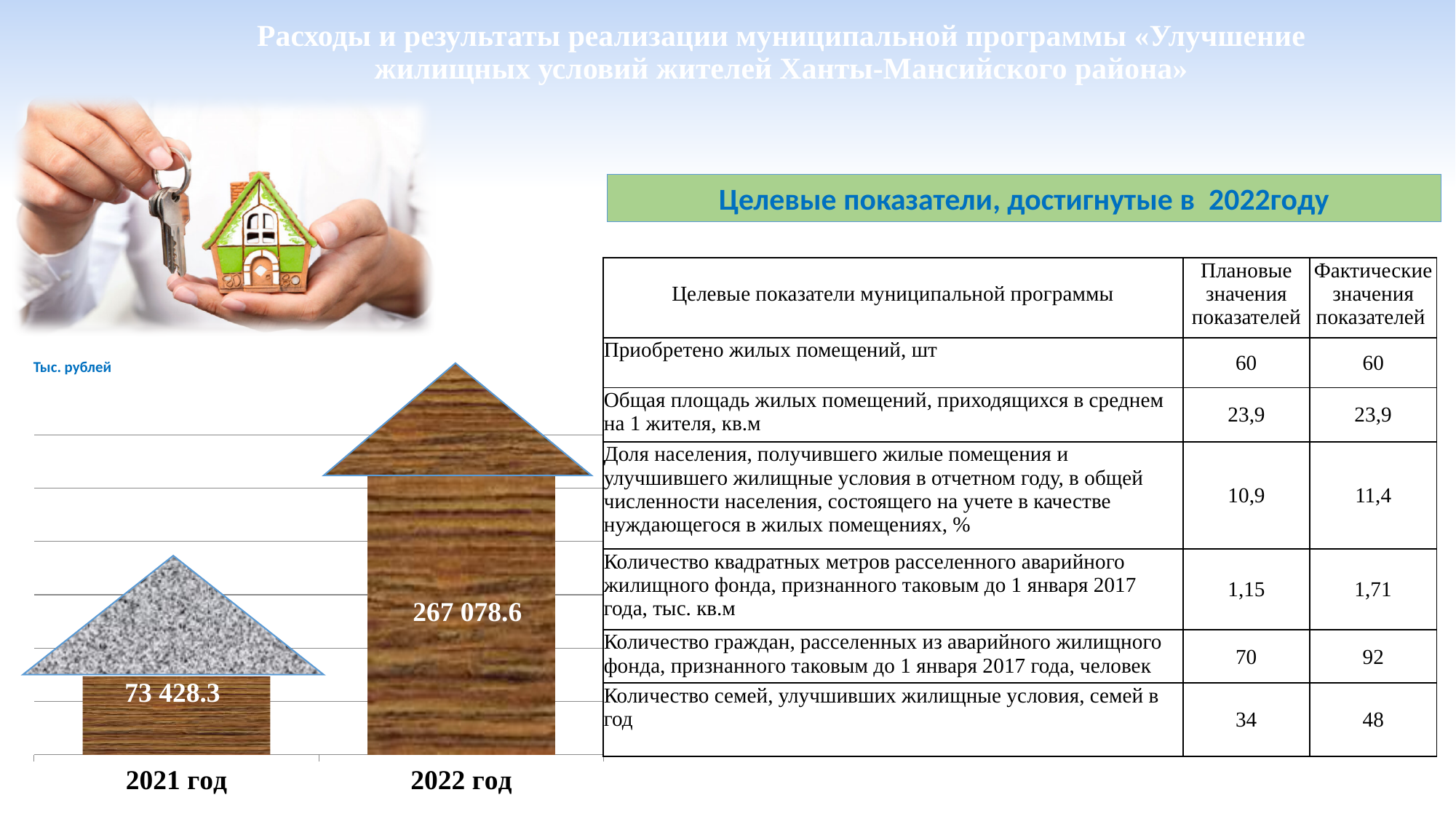
By how much does the value for 2022 год exceed the value for 2021 год on the bar chart? 193 650.3 What is the value shown for 2022 год on the bar chart? 267 078.6 What unit is indicated for the values on the bar chart? Тыс. рублей Is the value for 2022 год larger or smaller than the value for 2021 год on the bar chart? larger Which year has the lower value on the bar chart? 2021 год Do the values on the bar chart rise or fall from 2021 год to 2022 год? rise What kind of chart is shown on the left of the slide? bar chart How many categories (years) are plotted on the bar chart? 2 What is the value shown for 2021 год on the bar chart? 73 428.3 Which year has the higher value on the bar chart? 2022 год